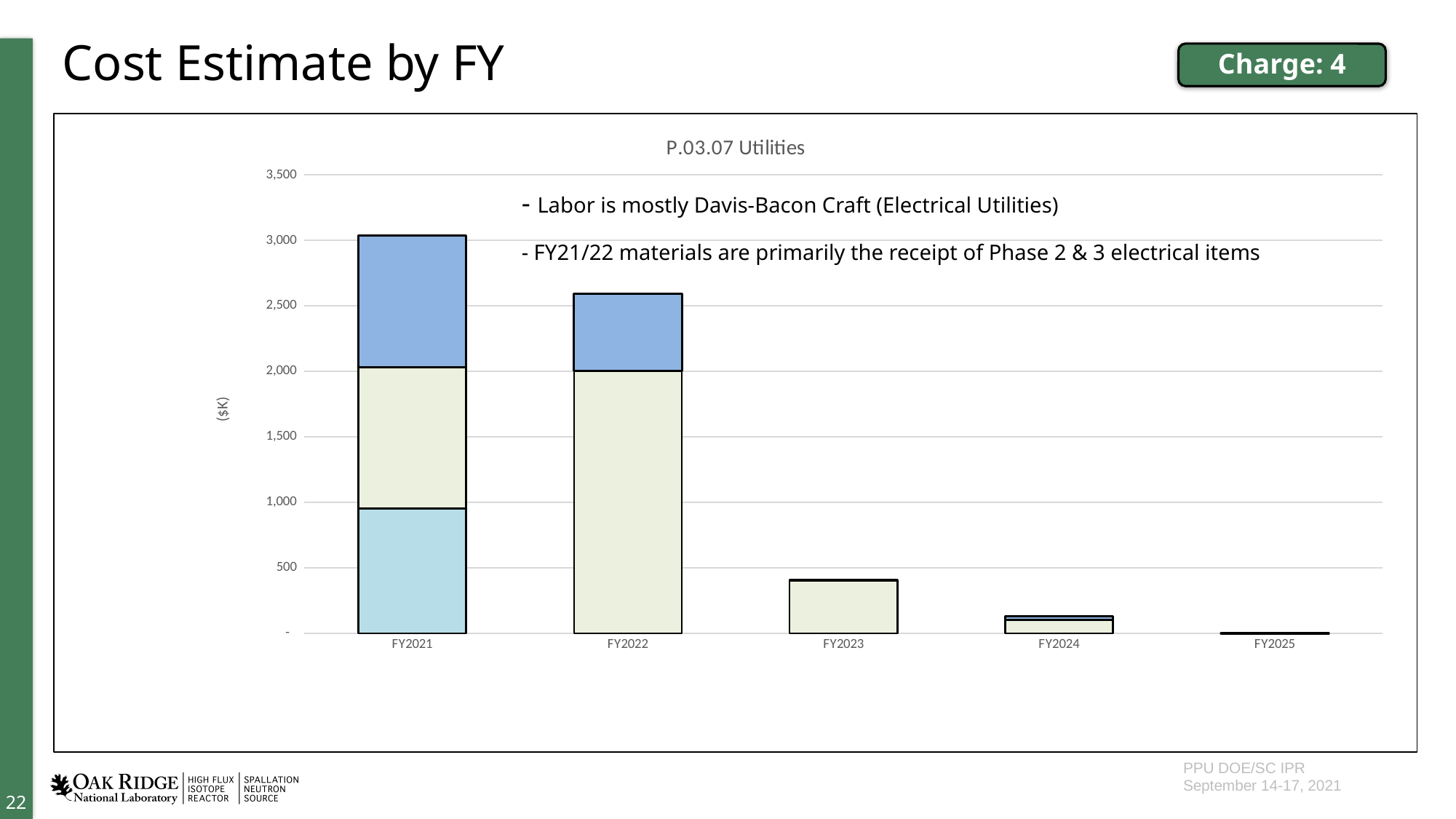
Is the total bar height for FY2021 greater or less than 2,500? greater Which fiscal year has the shortest bar in the chart? FY2025 Which bar is taller, FY2022 or FY2023? FY2022 Is the total bar height for FY2024 greater or less than 500? less How many fiscal years are shown on the x axis of the chart? 5 What kind of chart is shown on the slide? Stacked bar chart What is the label on the vertical axis of the chart? ($K) What is the title of the chart? P.03.07 Utilities Do the bar totals rise or fall from FY2021 to FY2025? fall Is the total bar height for FY2022 greater or less than 2,500? greater Which fiscal year has the tallest bar in the chart? FY2021